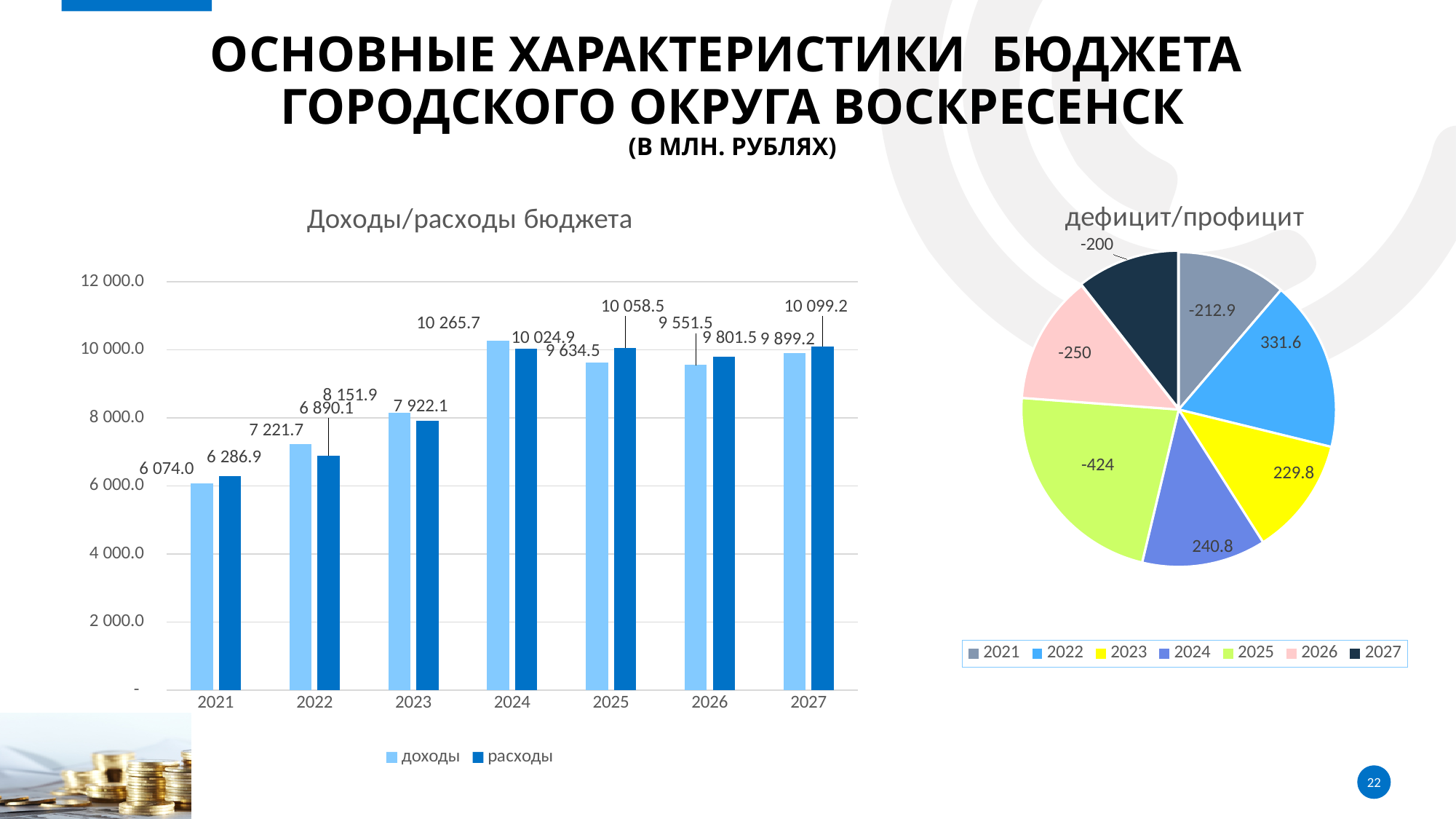
How many years are shown in the legend of the pie chart 'дефицит/профицит'? 7 In the pie chart 'дефицит/профицит', what is the value for 2025? -424 In the chart 'Доходы/расходы бюджета', how many series does the legend list? 2 What type of chart is 'Доходы/расходы бюджета'? bar chart In the chart 'Доходы/расходы бюджета', what is the value of расходы for 2027? 10 099.2 In the chart 'Доходы/расходы бюджета', which year has the lowest расходы? 2021 In the chart 'Доходы/расходы бюджета', what is the difference between расходы and доходы in 2025? 424.0 In the pie chart 'дефицит/профицит', what is the value for 2022? 331.6 In the chart 'Доходы/расходы бюджета', what is the value of расходы for 2021? 6 286.9 In the chart 'Доходы/расходы бюджета', which year has the highest доходы? 2024 In the chart 'Доходы/расходы бюджета', which is larger in 2022: доходы or расходы? доходы In the chart 'Доходы/расходы бюджета', what is the value of доходы for 2024? 10 265.7